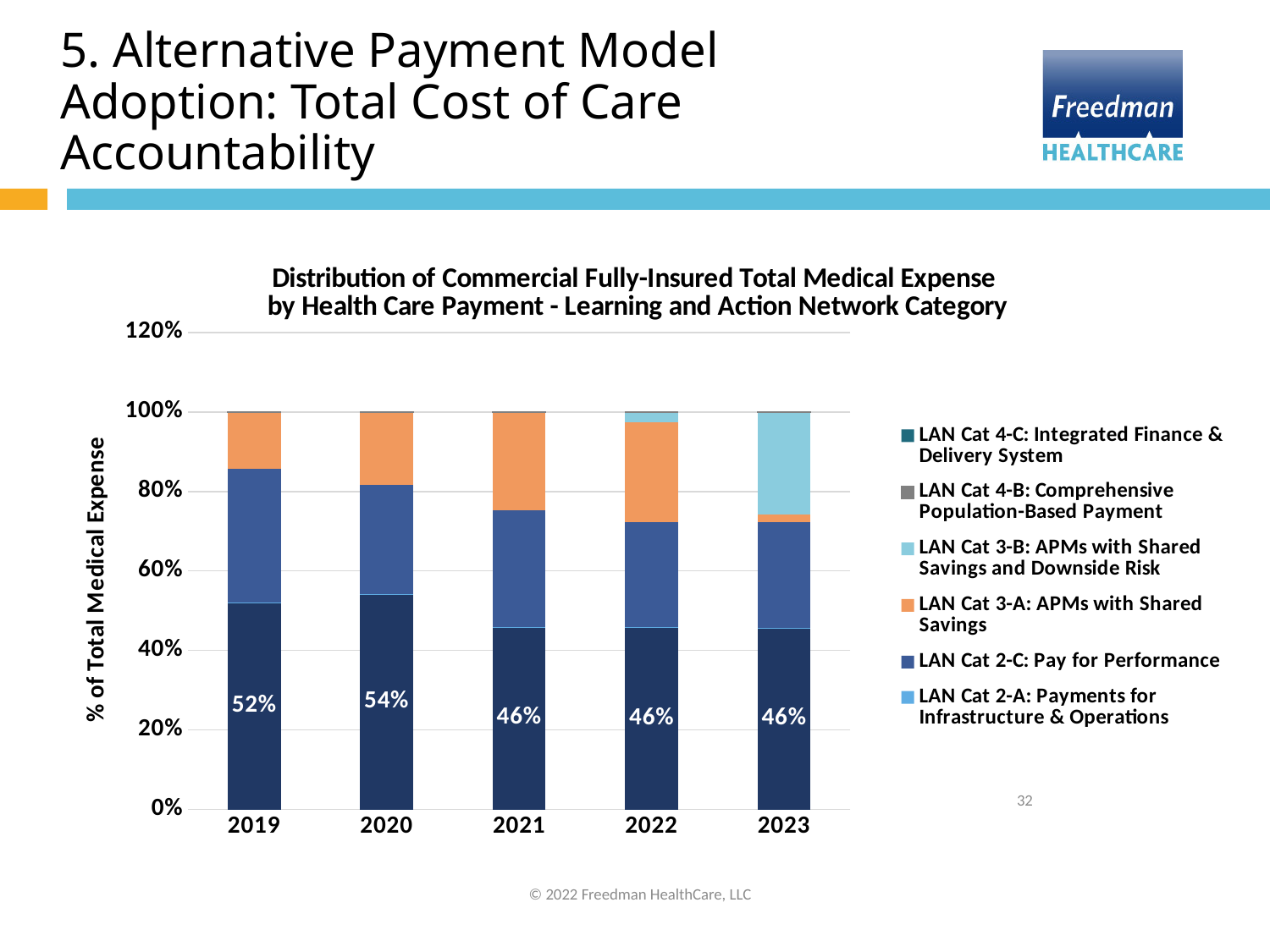
How many years are shown on the x axis of the chart? 5 What is the total height of each stacked bar on the chart? 100% What value is labeled on the bottom segment of the 2019 bar? 52% What is the difference between the labeled values for 2020 and 2019? 2 percentage points Which year has the larger labeled value, 2019 or 2023? 2019 What is the title of the chart's y axis? % of Total Medical Expense How many series does the chart's legend list? 6 Is the labeled value for 2022 greater or less than 60%? less What value is labeled on the bottom segment of the 2021 bar? 46% What type of chart is shown on the slide? Stacked bar chart Which year has the highest labeled value on its bottom segment? 2020 What value is labeled on the bottom segment of the 2020 bar? 54%